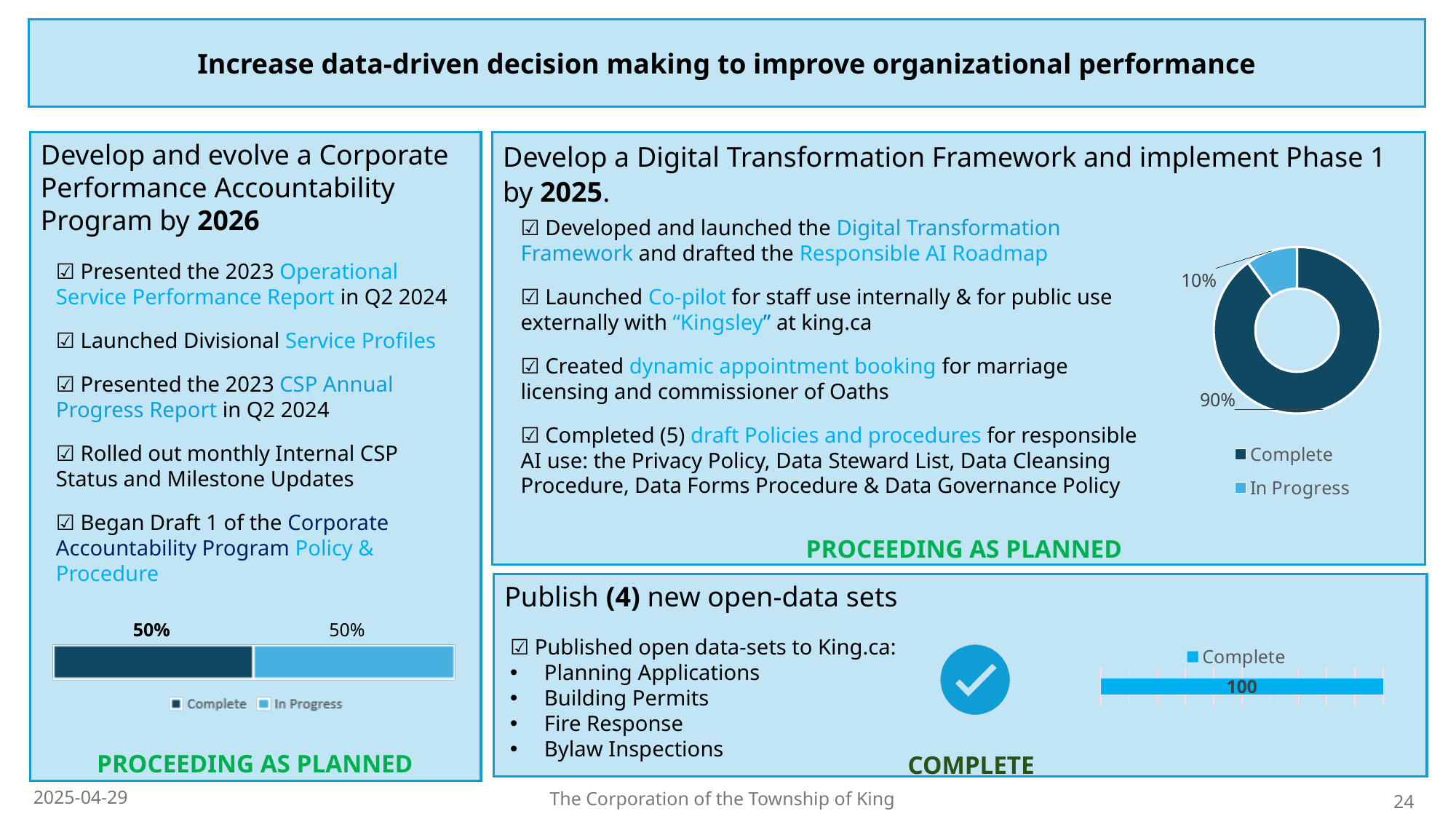
In the stacked bar chart in the bottom-left panel, what is the total of the Complete and In Progress segments? 100% What kind of chart is shown in the top-right panel? Donut (pie) chart In the donut chart in the top-right panel, what is the difference between the Complete and In Progress shares? 80% In the donut chart in the top-right panel, what share is labelled Complete? 90% In the donut chart in the top-right panel, which segment is larger, Complete or In Progress? Complete In the donut chart in the top-right panel, what share is labelled In Progress? 10% In the donut chart in the top-right panel, which colour represents the Complete segment? Dark blue How many entries does the legend of the donut chart in the top-right panel list? 2 In the bar chart in the bottom-right panel, what value is shown for Complete? 100 What kind of chart is shown in the bottom-left panel? Bar chart In the stacked bar chart in the bottom-left panel, what value is shown for Complete? 50% In the stacked bar chart in the bottom-left panel, what value is shown for In Progress? 50%